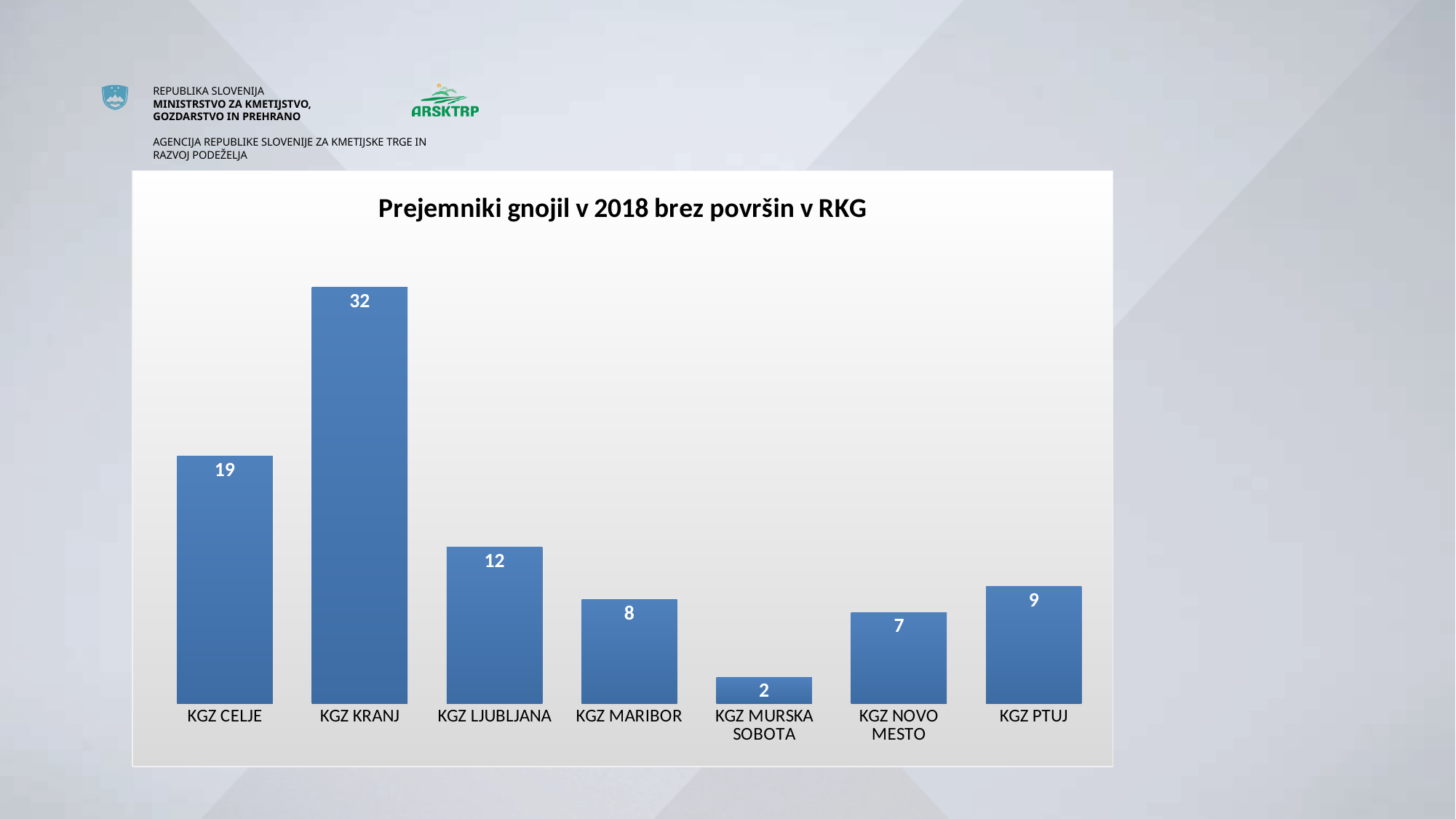
What is the value for KGZ NOVO MESTO? 7 Which category has the lowest value? KGZ MURSKA SOBOTA What is the title of the chart? Prejemniki gnojil v 2018 brez površin v RKG What kind of chart is shown on the slide? Bar chart What is the difference between the values for KGZ LJUBLJANA and KGZ MARIBOR? 4 What is the value for KGZ MURSKA SOBOTA? 2 How many categories are shown in the chart? 7 What is the value for KGZ KRANJ? 32 Which category has the highest value? KGZ KRANJ Which is larger, the value for KGZ PTUJ or the value for KGZ NOVO MESTO? KGZ PTUJ What is the difference between the values for KGZ KRANJ and KGZ CELJE? 13 What is the total of all the values shown in the chart? 89